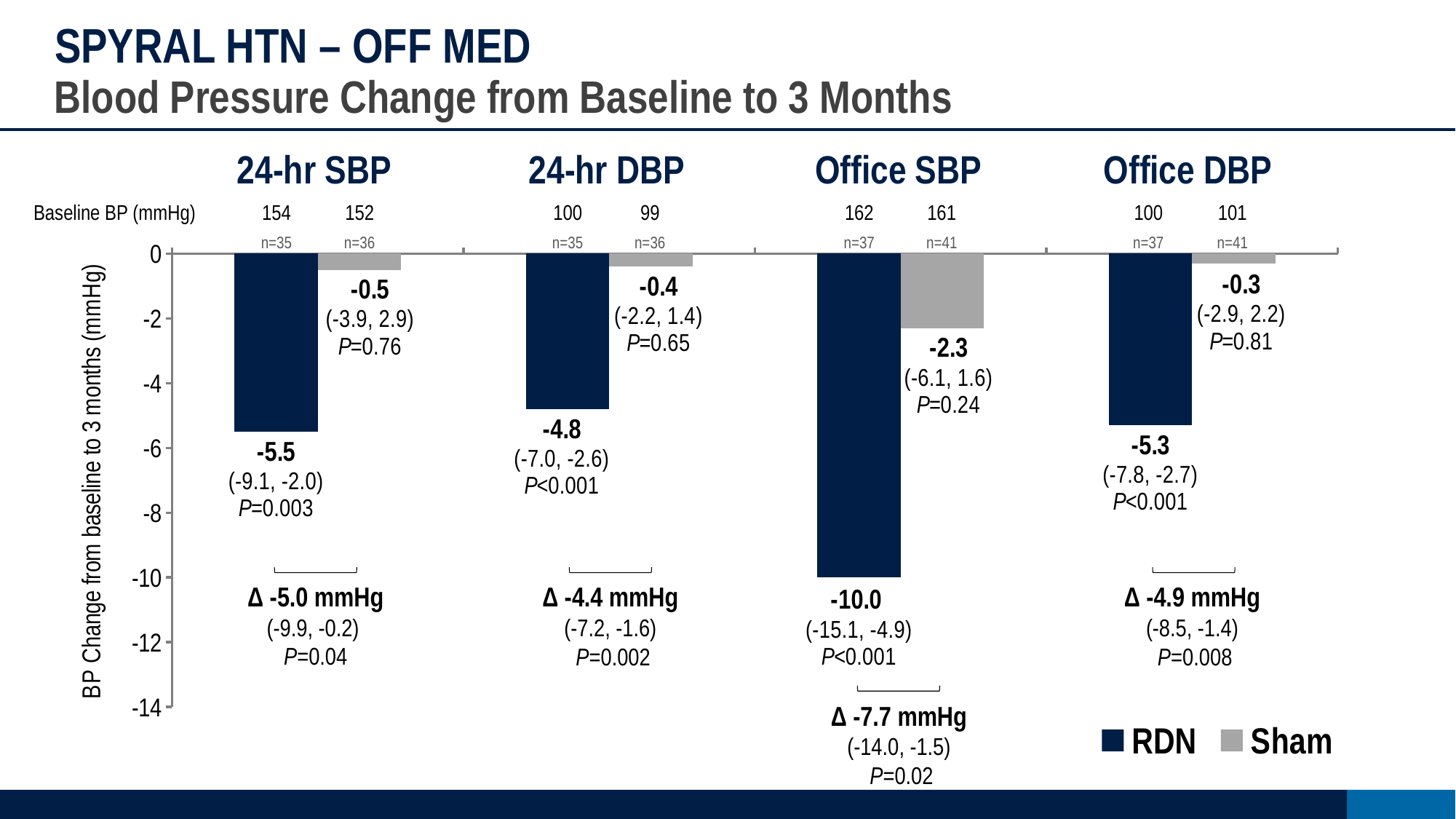
Which has a larger BP reduction in the Office SBP group, RDN or Sham? RDN What is the BP change from baseline for RDN in the Office DBP group? -5.3 What is the BP change from baseline for RDN in the 24-hr SBP group? -5.5 What colour represents the Sham group in the chart? Gray Which category shows the largest BP reduction for RDN? Office SBP How many BP categories are shown on the chart? 4 How many series does the legend list? 2 Which category shows the smallest BP change for Sham? Office DBP What is the BP change from baseline for Sham in the 24-hr DBP group? -0.4 What kind of chart is shown on the slide? Bar chart What is the difference between the RDN and Sham BP change in the 24-hr SBP group? -5.0 mmHg What is the BP change from baseline for Sham in the Office SBP group? -2.3